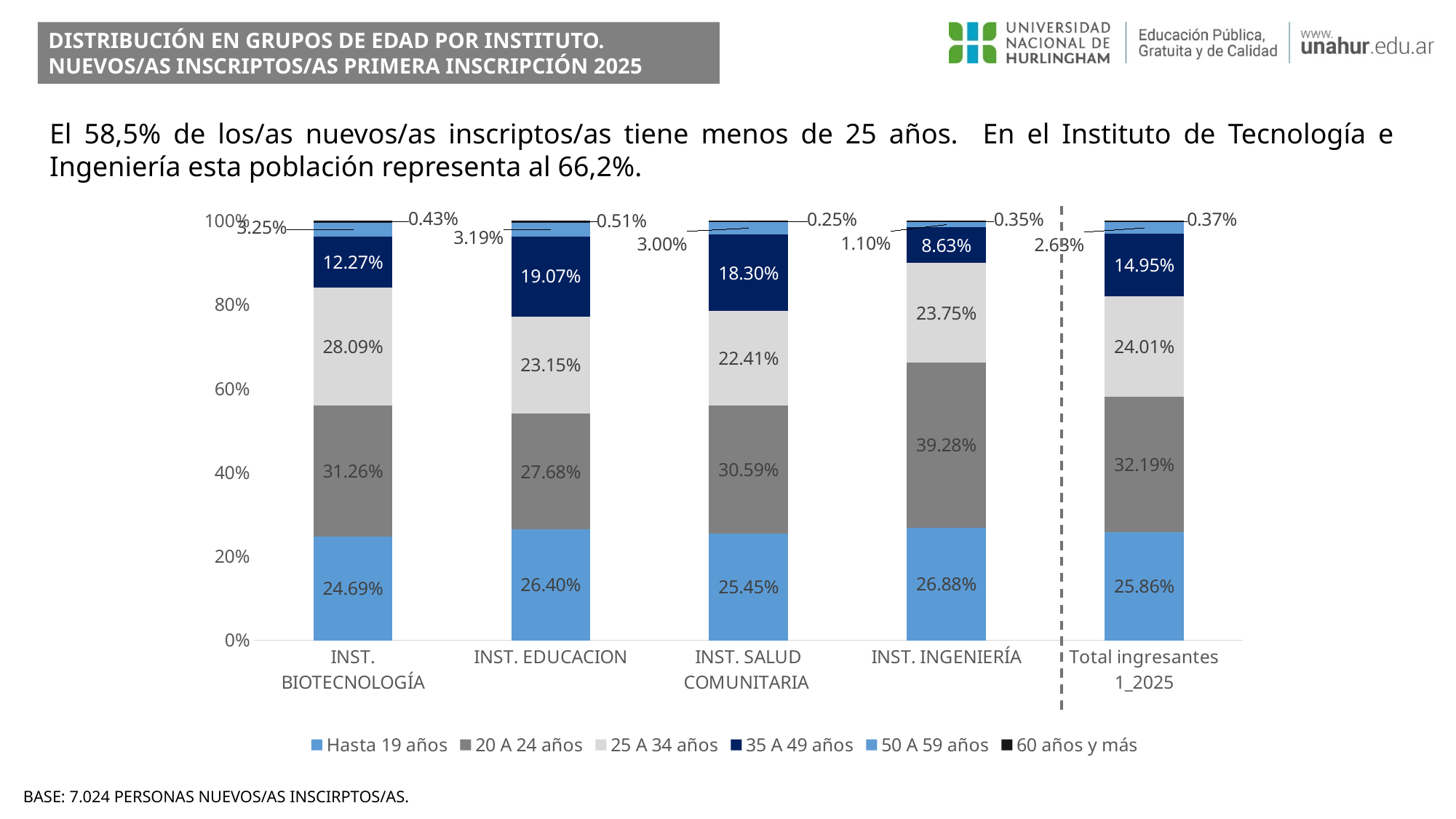
What is the first entry in the chart's legend? Hasta 19 años What is the value for the 20 A 24 años series for INST. INGENIERÍA? 39.28% What kind of chart is shown on the slide? Stacked bar chart What is the value for the 25 A 34 años series for Total ingresantes 1_2025? 24.01% How many series does the legend list? 6 What is the value for the 60 años y más series for INST. SALUD COMUNITARIA? 0.25% What is the difference between the 25 A 34 años values for INST. BIOTECNOLOGÍA and INST. EDUCACION? 4.94 percentage points Which category has the lowest value for the 35 A 49 años series? INST. INGENIERÍA What is the value for the 35 A 49 años series for INST. EDUCACION? 19.07% How many categories are shown on the x axis of the chart? 5 Which has the larger 20 A 24 años value, INST. SALUD COMUNITARIA or INST. EDUCACION? INST. SALUD COMUNITARIA Which category has the highest value for the Hasta 19 años series? INST. INGENIERÍA